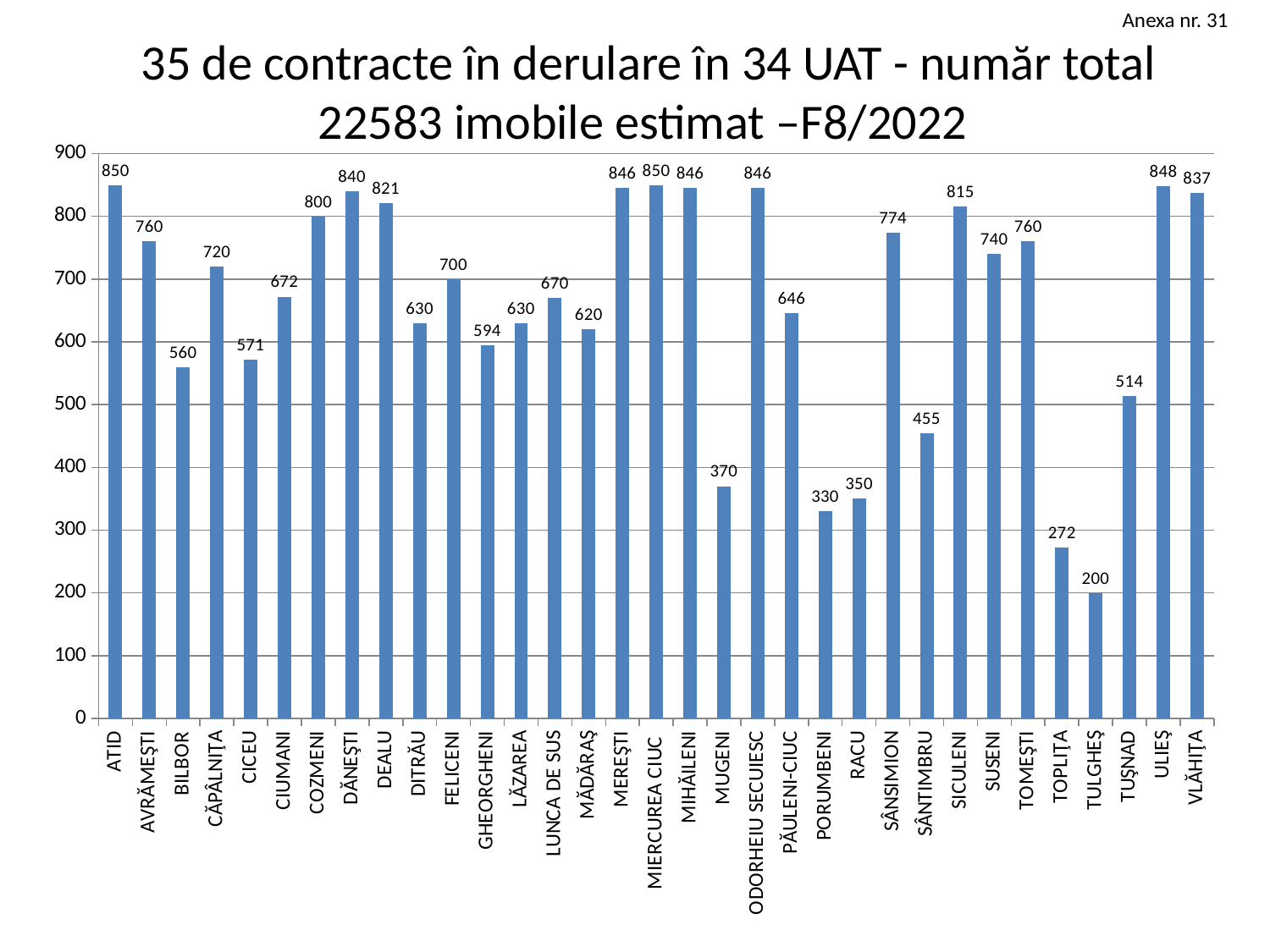
What is the difference between the values for ATID and TULGHEŞ? 650 What is the title of the chart? 35 de contracte în derulare în 34 UAT - număr total 22583 imobile estimat –F8/2022 What is the value for TULGHEŞ? 200 What is the value for SÂNTIMBRU? 455 What is the value for MIERCUREA CIUC? 850 Is the value for TOPLIŢA greater or less than 300? less Which is larger, the value for MUGENI or the value for TUŞNAD? TUŞNAD What is the value for PĂULENI-CIUC? 646 What is the difference between the values for SICULENI and SUSENI? 75 Which is larger, the value for CICEU or the value for CIUMANI? CIUMANI Which category has the lowest value? TULGHEŞ What kind of chart is shown on the slide? bar chart